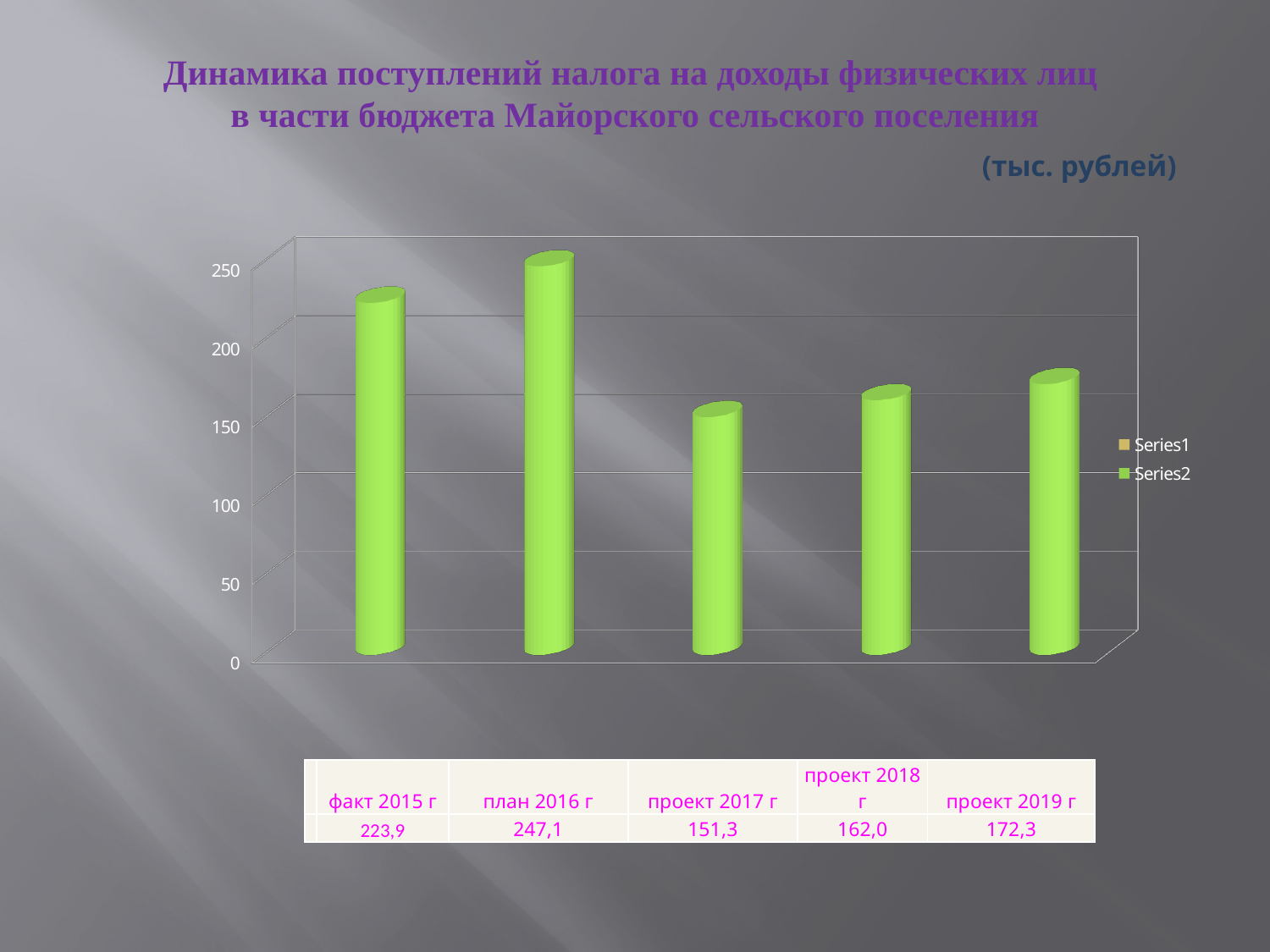
Which is larger, the value for проект 2018 г or the value for проект 2019 г? проект 2019 г Is the value for проект 2017 г greater or less than 200? less What is the value for проект 2019 г? 172,3 What is the difference between the values for план 2016 г and факт 2015 г? 23,2 How many categories are shown on the x axis? 5 What is the difference between the values for проект 2019 г and проект 2018 г? 10,3 What is the value for план 2016 г? 247,1 What is the value for факт 2015 г? 223,9 What is the value for проект 2017 г? 151,3 What kind of chart is shown on the slide? bar chart Which category has the highest value? план 2016 г Which category has the lowest value? проект 2017 г